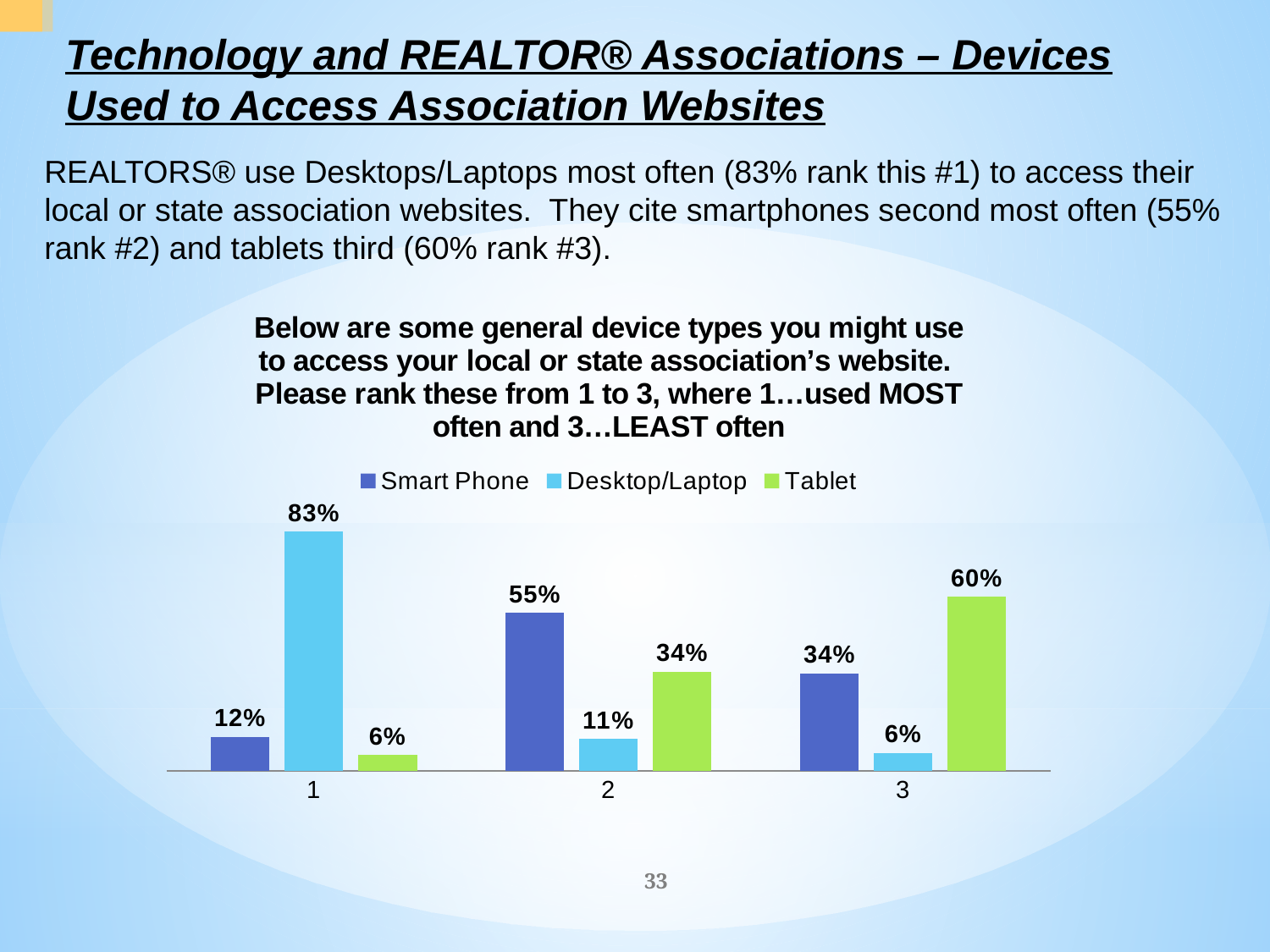
Which is larger at rank 2: Smart Phone or Tablet? Smart Phone What kind of chart is shown on the slide? Bar chart Which colour represents Tablet in the chart? Green What percentage of respondents ranked Desktop/Laptop as #1? 83% What is the value for Desktop/Laptop at rank 2? 11% What is the value for Smart Phone at rank 2? 55% How many series does the legend list? 3 What is the difference between the Desktop/Laptop and Smart Phone values at rank 1? 71% Which device has the lowest value at rank 3? Desktop/Laptop How many rank categories are shown on the x axis? 3 Which device has the highest value at rank 1? Desktop/Laptop What is the value for Tablet at rank 3? 60%